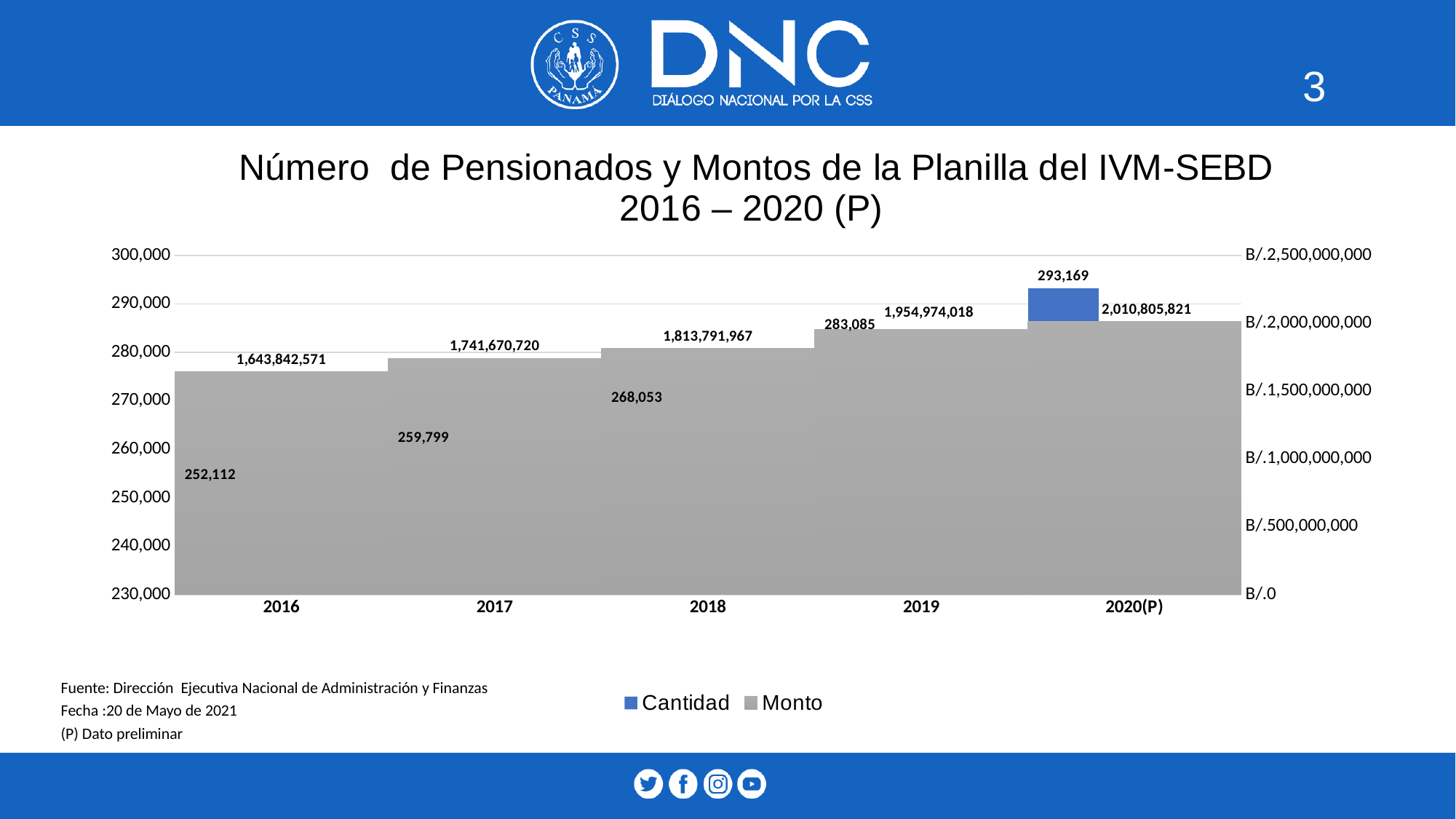
Do the Cantidad values rise or fall from 2016 to 2020(P)? rise What is the difference in Monto between 2020(P) and 2019? 55,831,803 How many years are shown on the x axis? 5 How many series does the legend list? 2 What is the Cantidad value for 2020(P)? 293,169 What is the Monto value for 2019? 1,954,974,018 Which year has the lowest Monto value? 2016 What is the Monto value for 2017? 1,741,670,720 Which year has the highest Cantidad value? 2020(P) Which is larger, the Cantidad for 2018 or the Cantidad for 2017? 2018 What is the Cantidad value for 2016? 252,112 What is the difference in Cantidad between 2020(P) and 2019? 10,084